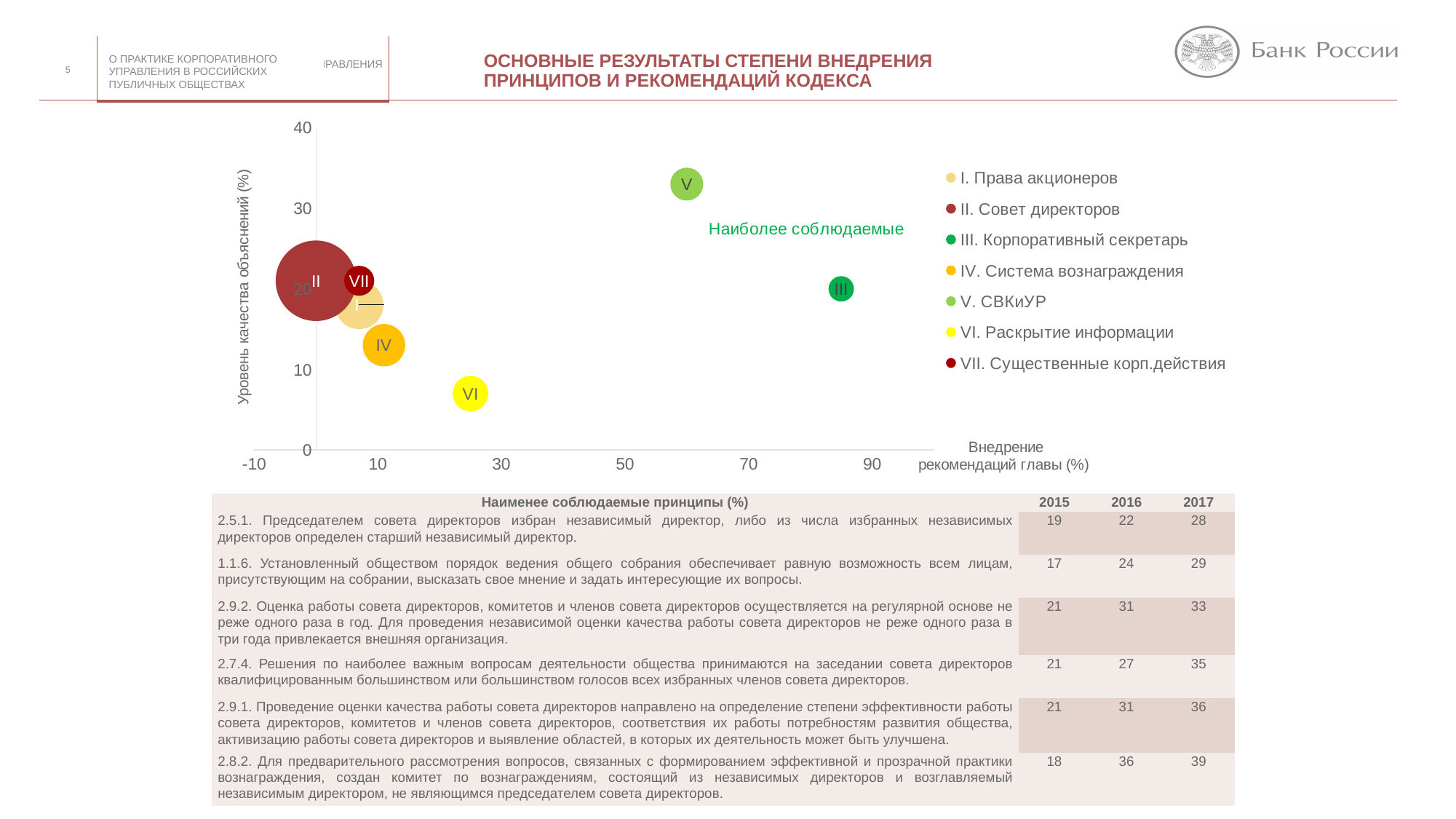
Is the vertical-axis value for bubble V greater or less than 30? greater What kind of chart is shown on the slide? Bubble chart How many series does the chart legend list? 7 Which series has the lowest value on the vertical axis (Уровень качества объяснений)? VI. Раскрытие информации Is the vertical-axis value for bubble VI greater or less than 10? less How many bubbles are plotted on the chart? 7 Is the horizontal-axis value for bubble III greater or less than 70? greater Which series is furthest to the right on the horizontal axis (Внедрение рекомендаций главы)? III. Корпоративный секретарь Which bubble is higher on the vertical axis, V or VI? V Which series has the highest value on the vertical axis (Уровень качества объяснений)? V. СВКиУР What annotation text is written in green near the top right of the plot area? Наиболее соблюдаемые Which bubble is further right on the horizontal axis, III or II? III